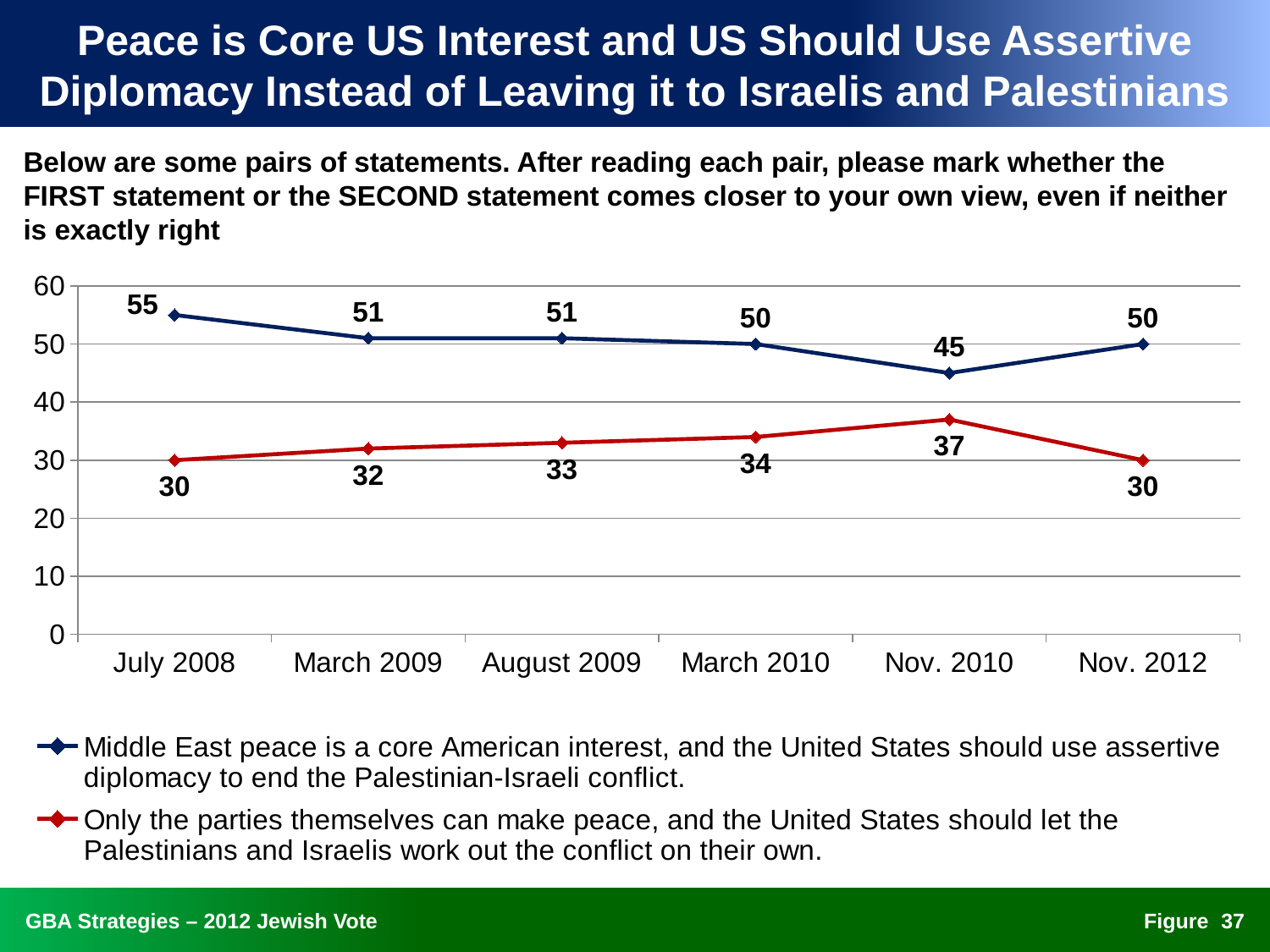
In which period is the red series (parties themselves) at its highest? Nov. 2010 What is the difference between the blue and red series in July 2008? 25 What is the difference between the blue and red series in Nov. 2010? 8 What is the value of the blue series (Middle East peace is a core American interest) in July 2008? 55 In which period is the blue series (core American interest) at its lowest? Nov. 2010 Which series has the higher value in March 2010? Middle East peace is a core American interest (blue) What kind of chart is shown on the slide? Line chart How many time periods are shown on the x axis? 6 What is the value of the blue series in Nov. 2012? 50 What is the value of the red series (Only the parties themselves can make peace) in Nov. 2010? 37 How many series does the legend list? 2 Does the red series rise or fall from July 2008 to Nov. 2010? Rise